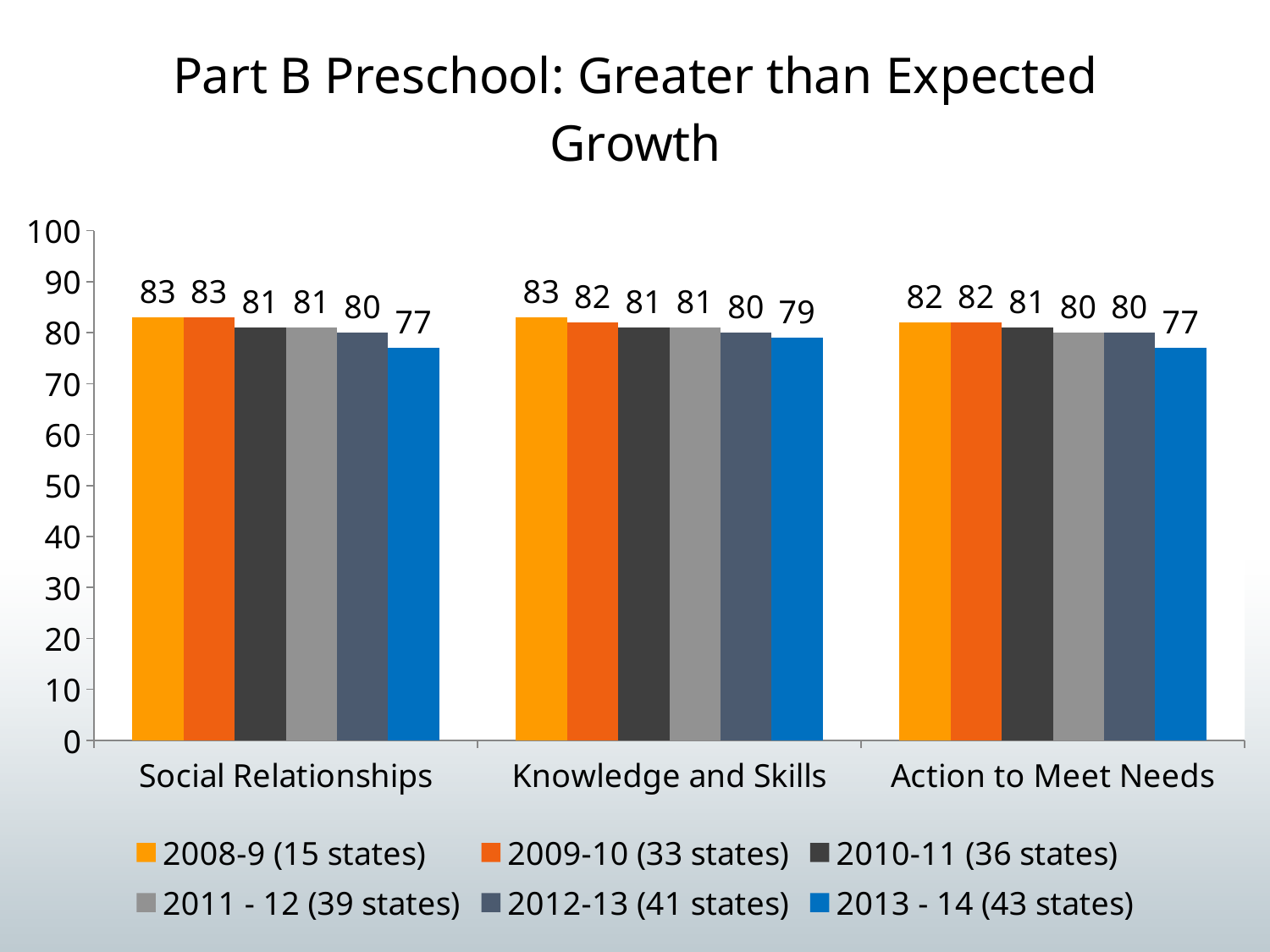
What is the value for 2008-9 (15 states) in the Social Relationships category? 83 How many categories are shown on the x axis? 3 Within the Social Relationships category, do the values rise or fall from the 2008-9 series to the 2013 - 14 series? Fall How many series does the legend list? 6 Which series has the highest value in the Knowledge and Skills category? 2008-9 (15 states) Which series has the lowest value in the Action to Meet Needs category? 2013 - 14 (43 states) What kind of chart is shown on the slide? Bar chart What is the difference between the 2008-9 (15 states) value and the 2013 - 14 (43 states) value in the Social Relationships category? 6 What is the value for 2011 - 12 (39 states) in the Action to Meet Needs category? 80 What is the title of the chart? Part B Preschool: Greater than Expected Growth What is the value for 2013 - 14 (43 states) in the Knowledge and Skills category? 79 Which is larger in the Knowledge and Skills category: the value for 2009-10 (33 states) or the value for 2012-13 (41 states)? 2009-10 (33 states)